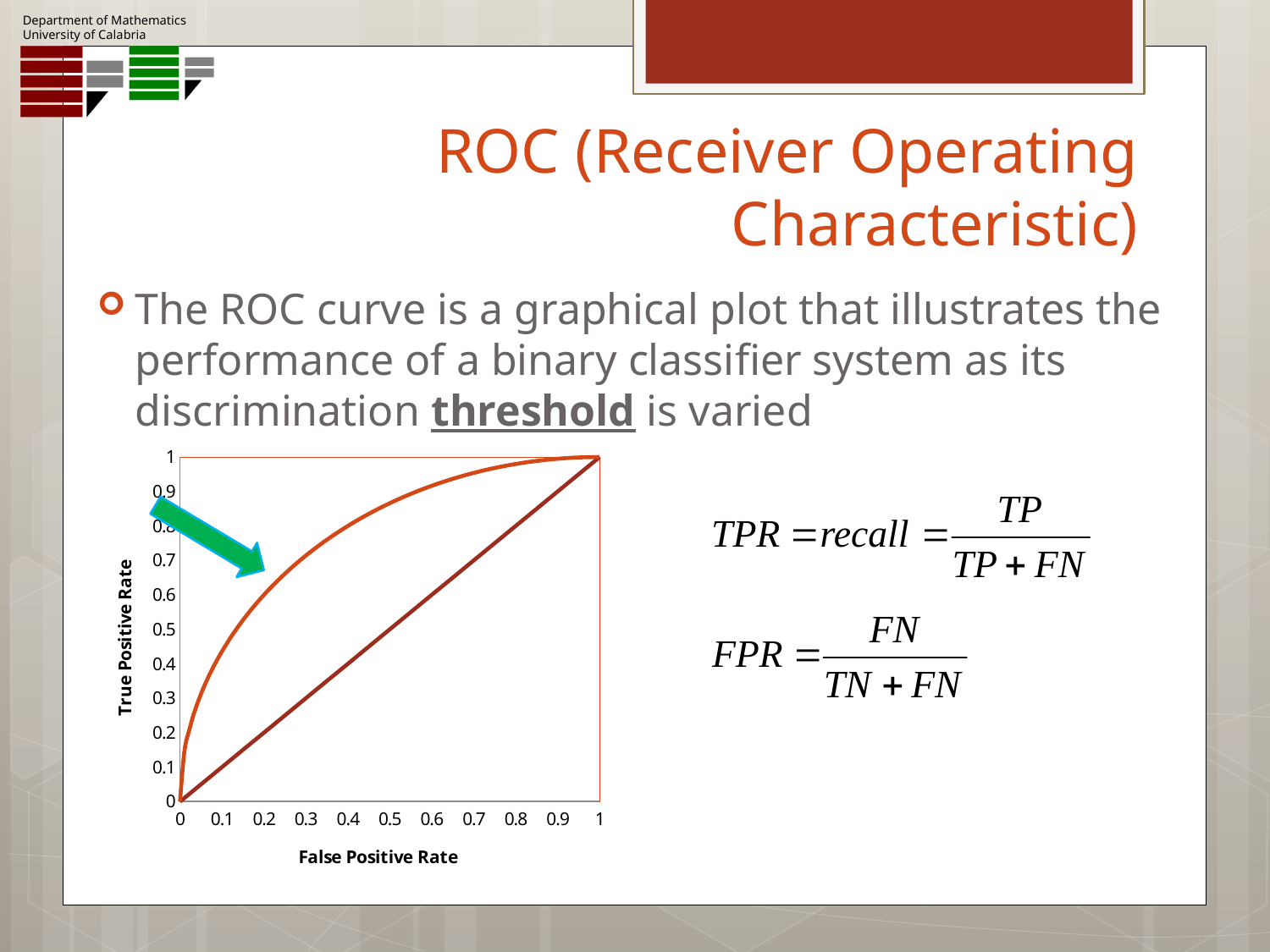
What kind of chart is shown on the slide? Line chart At a False Positive Rate of 0.5, is the True Positive Rate of the curved line greater or less than 0.7? greater What is the True Positive Rate of the curved line when the False Positive Rate is 0? 0 What is the highest value shown on the y axis of the chart? 1 How many lines are plotted on the chart? 2 How many tick labels are shown on the x axis of the chart? 11 What is the title of the x axis of the chart? False Positive Rate At a False Positive Rate of 0.2, is the True Positive Rate of the straight diagonal line greater or less than 0.5? less At a False Positive Rate of 0.3, which line has the higher True Positive Rate, the curved line or the straight diagonal line? The curved line What is the True Positive Rate of the curved line when the False Positive Rate is 1? 1 What is the title of the y axis of the chart? True Positive Rate Does the curved line rise or fall as the False Positive Rate increases from 0 to 1? Rise